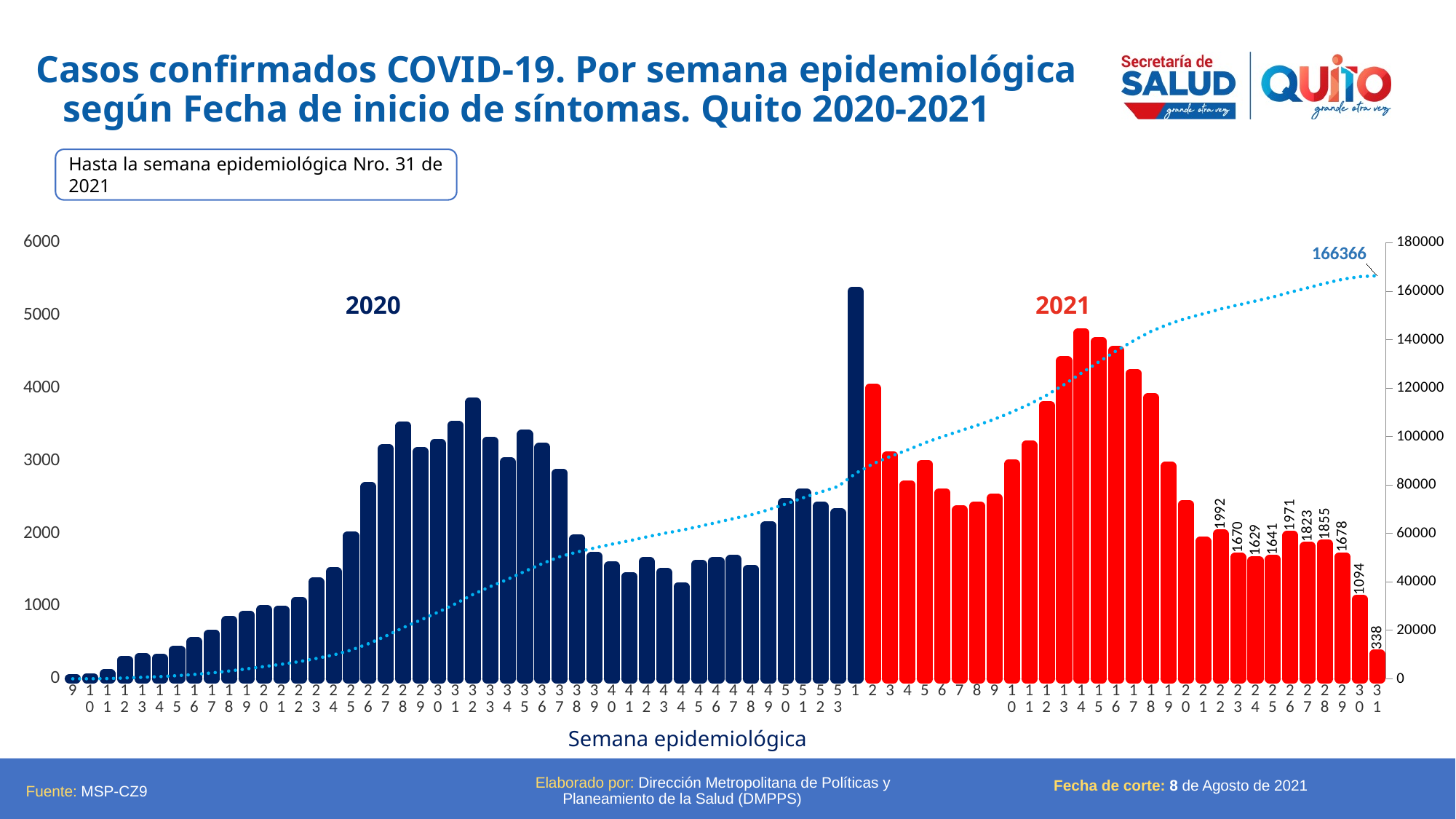
What is the value for epidemiological week 22 of 2021? 1992 Among the labelled weeks 22 to 31 of 2021, which week has the lowest value? Week 31 Do the values rise or fall from week 28 to week 31 of 2021? fall What is the value for epidemiological week 30 of 2021? 1094 What is the title of the x axis? Semana epidemiológica Which is larger, the value for week 26 of 2021 or week 27 of 2021? Week 26 of 2021 What cumulative total is labelled at the end of the dotted line? 166366 Is the value for week 2 of 2021 greater or less than 3000? greater What is the value for epidemiological week 31 of 2021? 338 What is the difference between the values for week 22 and week 23 of 2021? 322 What is the difference between the values for week 25 and week 24 of 2021? 12 What kind of chart is shown on the slide? Combination bar and line chart